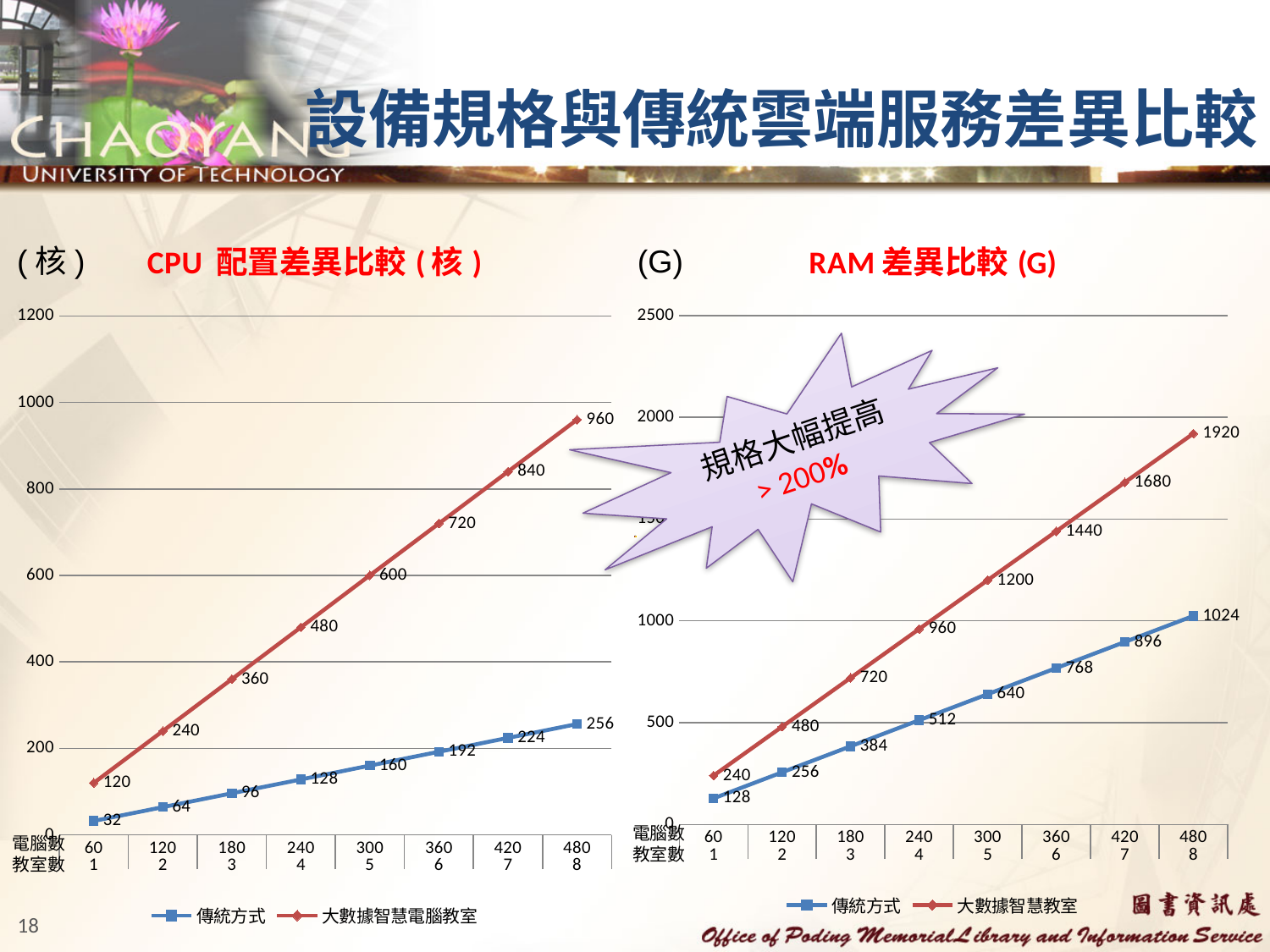
How many series does the legend of the RAM 差異比較(G) chart list? 2 In the CPU 配置差異比較(核) chart, what is the value for 傳統方式 at 60 電腦數 (1 教室數)? 32 In the RAM 差異比較(G) chart, what is the lowest value plotted for 大數據智慧教室? 240 In the RAM 差異比較(G) chart, what is the value for 大數據智慧教室 at 300 電腦數 (5 教室數)? 1200 In the CPU 配置差異比較(核) chart, at which 電腦數 does 傳統方式 reach its highest value? 480 How many data points does each series have in the CPU 配置差異比較(核) chart? 8 In the RAM 差異比較(G) chart, which series has the larger value at 120 電腦數 (2 教室數)? 大數據智慧教室 In the CPU 配置差異比較(核) chart, what is the difference between 大數據智慧電腦教室 and 傳統方式 at 240 電腦數 (4 教室數)? 352 In the RAM 差異比較(G) chart, what is the value for 傳統方式 at 480 電腦數 (8 教室數)? 1024 In the RAM 差異比較(G) chart, what is the difference between 大數據智慧教室 and 傳統方式 at 480 電腦數 (8 教室數)? 896 In the CPU 配置差異比較(核) chart, what is the value for 大數據智慧電腦教室 at 480 電腦數 (8 教室數)? 960 What kind of chart is the CPU 配置差異比較(核) chart? Line chart